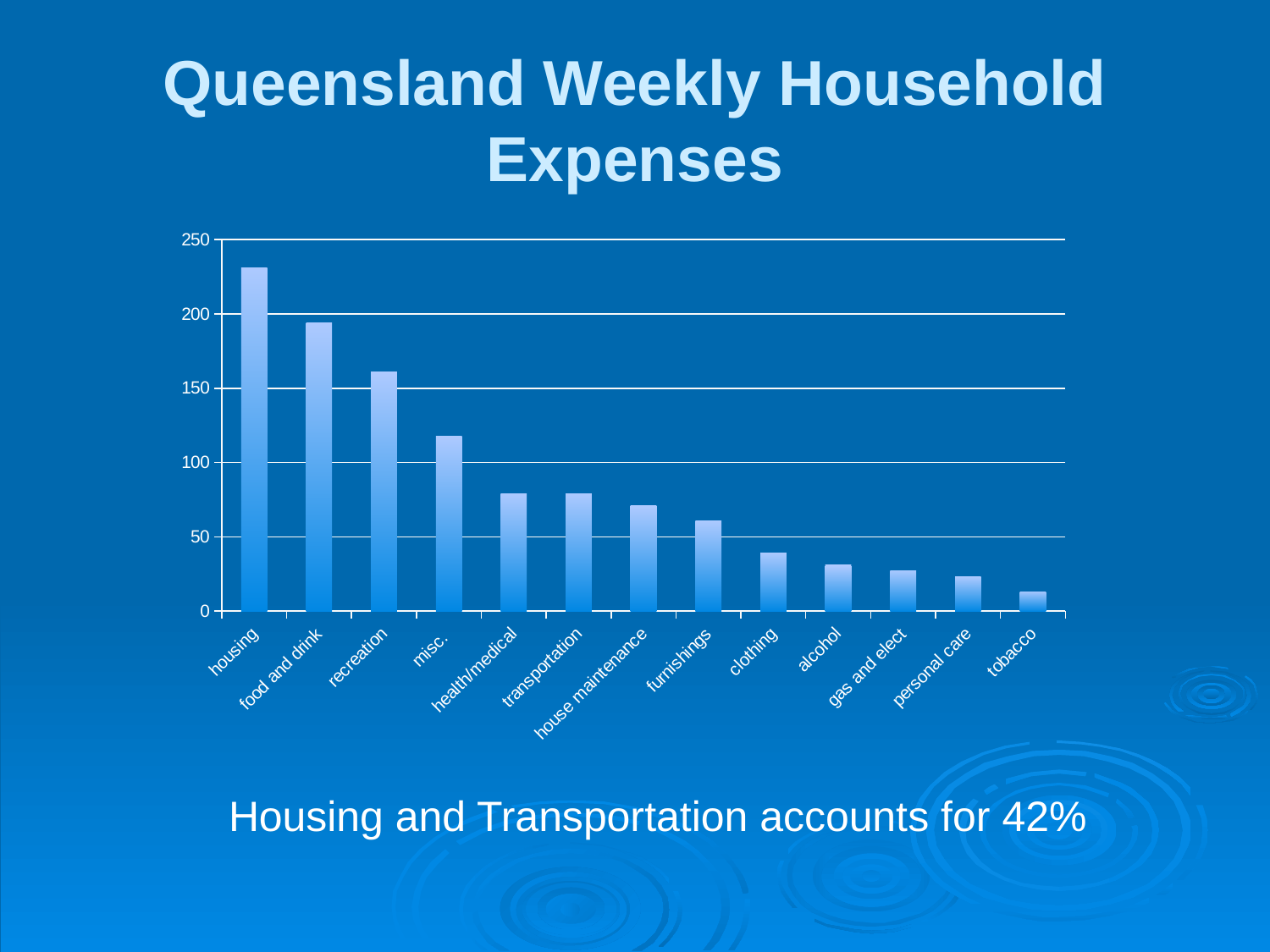
Is the value for house maintenance greater or less than 50? greater What kind of chart is shown on the slide? bar chart Is the value for misc. greater or less than 100? greater Is the value for housing greater or less than 200? greater Which category has the highest weekly expense? housing Which category has the lowest weekly expense? tobacco Which is larger, the value for housing or the value for food and drink? housing How many expense categories are shown on the x axis? 13 Do the values rise or fall moving from left to right along the x axis? fall What is the title of the slide containing the chart? Queensland Weekly Household Expenses